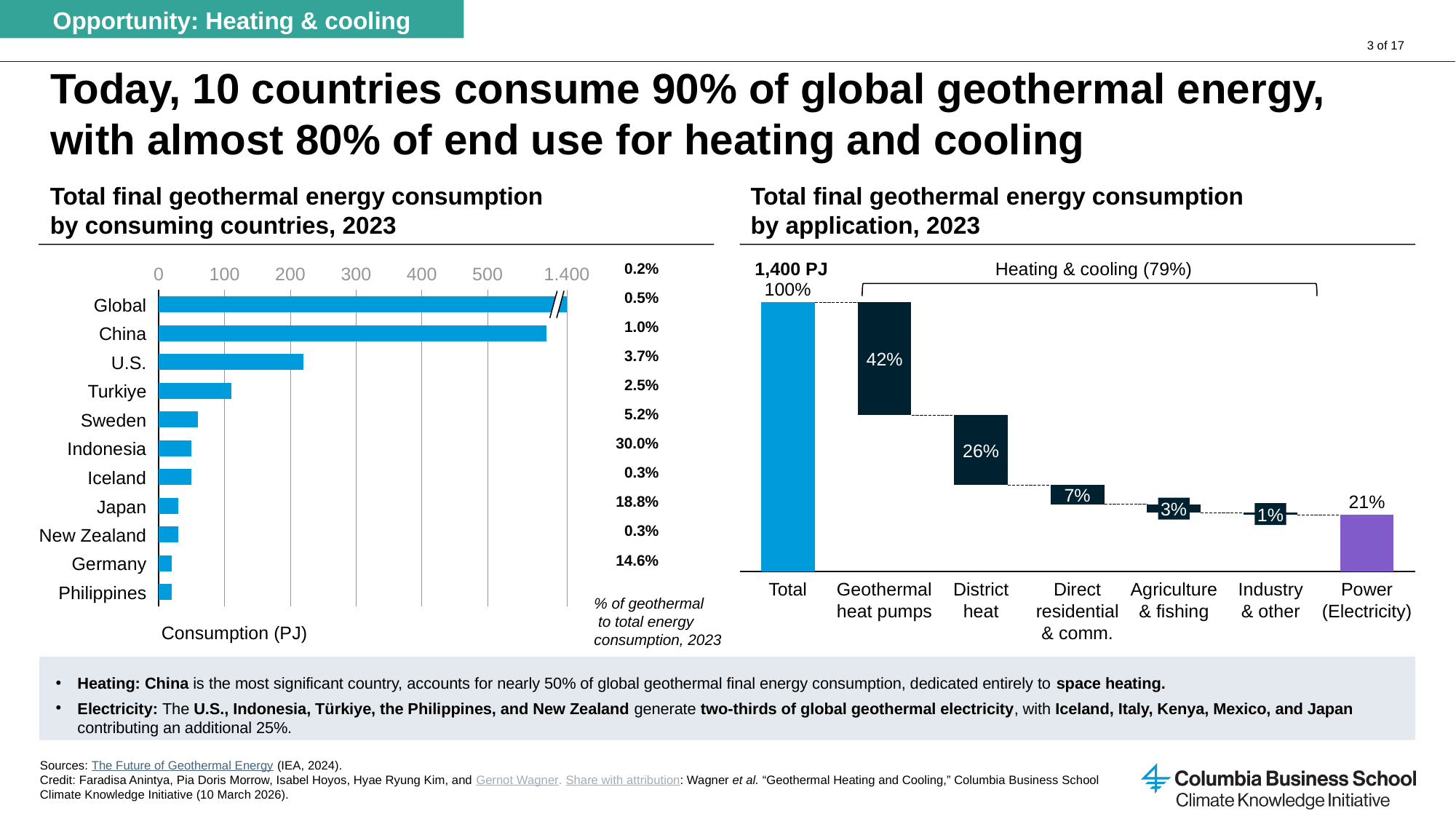
In the 'Total final geothermal energy consumption by consuming countries, 2023' chart, which country (excluding Global) has the longest bar? China In the 'Total final geothermal energy consumption by consuming countries, 2023' chart, is the value for U.S. greater or less than 300? less In the 'Total final geothermal energy consumption by application, 2023' chart, what percentage is shown for Power (Electricity)? 21% In the 'Total final geothermal energy consumption by application, 2023' chart, what percentage is shown for Geothermal heat pumps? 42% In the 'Total final geothermal energy consumption by consuming countries, 2023' chart, which has the larger value, U.S. or Turkiye? U.S. In the 'Total final geothermal energy consumption by application, 2023' chart, what total value in PJ is shown for the Total bar? 1,400 PJ In the 'Total final geothermal energy consumption by consuming countries, 2023' chart, is the value for Sweden greater or less than 100? less In the 'Total final geothermal energy consumption by application, 2023' chart, what is the difference in percentage points between Geothermal heat pumps and District heat? 16% In the 'Total final geothermal energy consumption by consuming countries, 2023' chart, is the value for China greater or less than 500? greater In the 'Total final geothermal energy consumption by application, 2023' chart, which application has the smallest percentage? Industry & other How many bars are plotted in the 'Total final geothermal energy consumption by consuming countries, 2023' chart? 11 What kind of chart is the 'Total final geothermal energy consumption by consuming countries, 2023' chart? bar chart